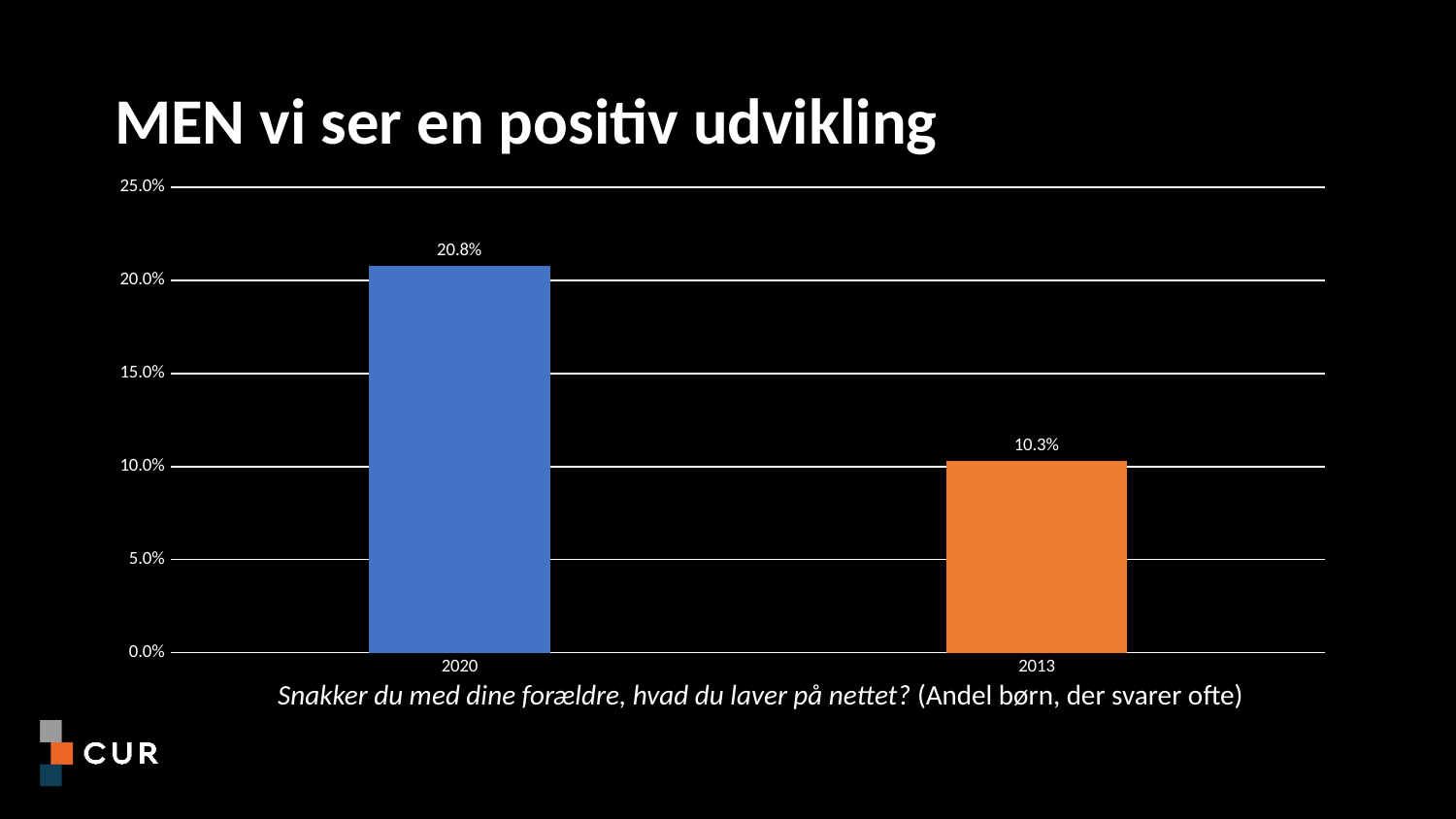
What is the difference between the values for 2020 and 2013? 10.5% Which is larger, the value for 2020 or the value for 2013? 2020 Is the value for 2013 greater or less than 15.0%? less Is the value for 2020 greater or less than 20.0%? greater What kind of chart is shown on the slide? bar chart How many categories are shown on the x axis? 2 What is the value for 2020? 20.8% Which category has the highest value? 2020 What colour is the bar for 2013? orange What is the title of the slide? MEN vi ser en positiv udvikling Which category has the lowest value? 2013 What is the value for 2013? 10.3%